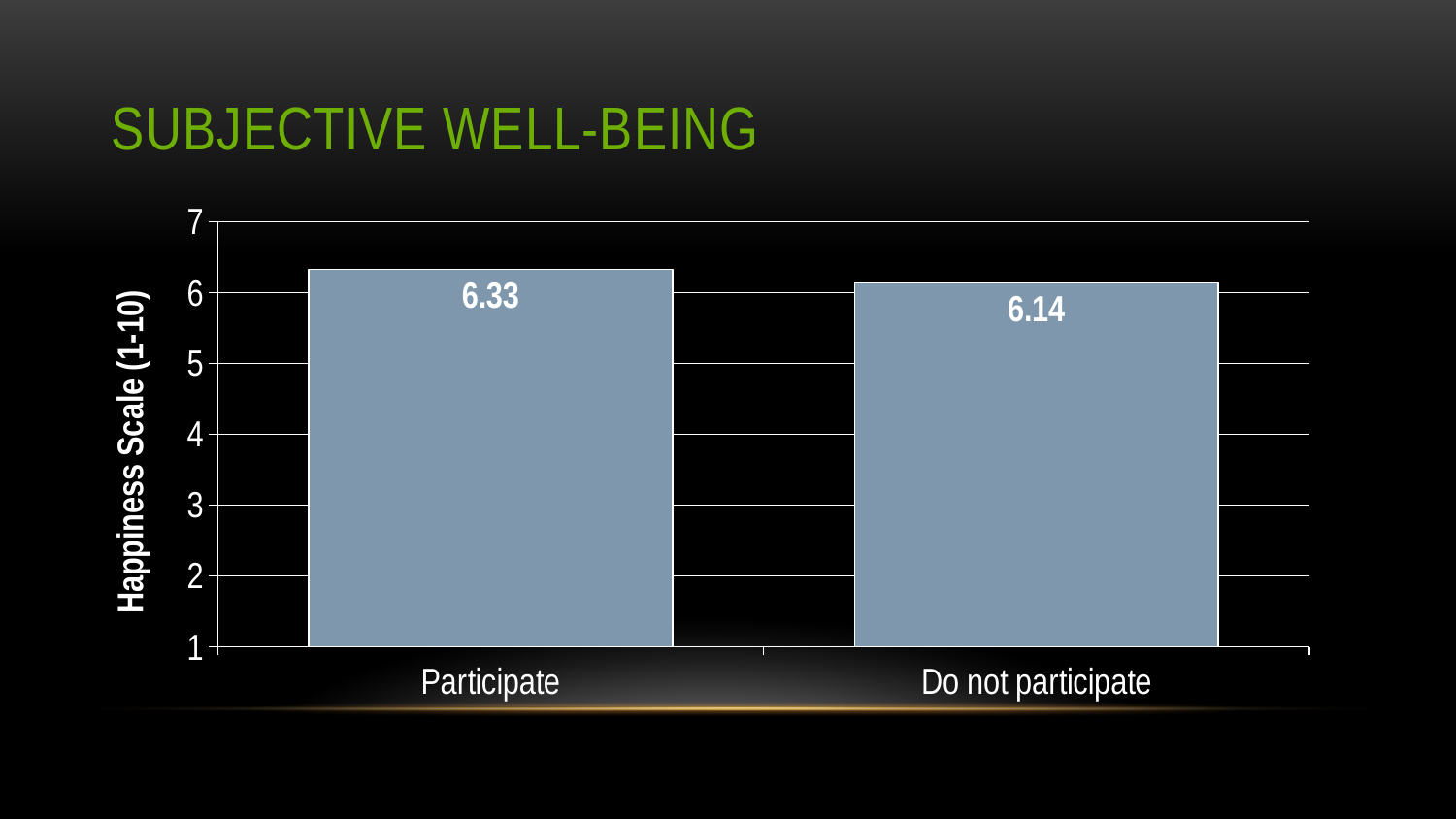
Which category has the lower happiness scale value? Do not participate What kind of chart is shown on the slide? bar chart What is the label of the vertical axis? Happiness Scale (1-10) What is the difference between the happiness values for Participate and Do not participate? 0.19 Which category has the higher happiness scale value? Participate Is the value for Do not participate greater or less than 7? less What is the title of the slide? SUBJECTIVE WELL-BEING Is the value for Participate larger or smaller than the value for Do not participate? larger Is the value for Participate greater or less than 6? greater What is the happiness scale value for the Participate group? 6.33 How many categories are shown on the x axis? 2 What is the happiness scale value for the Do not participate group? 6.14